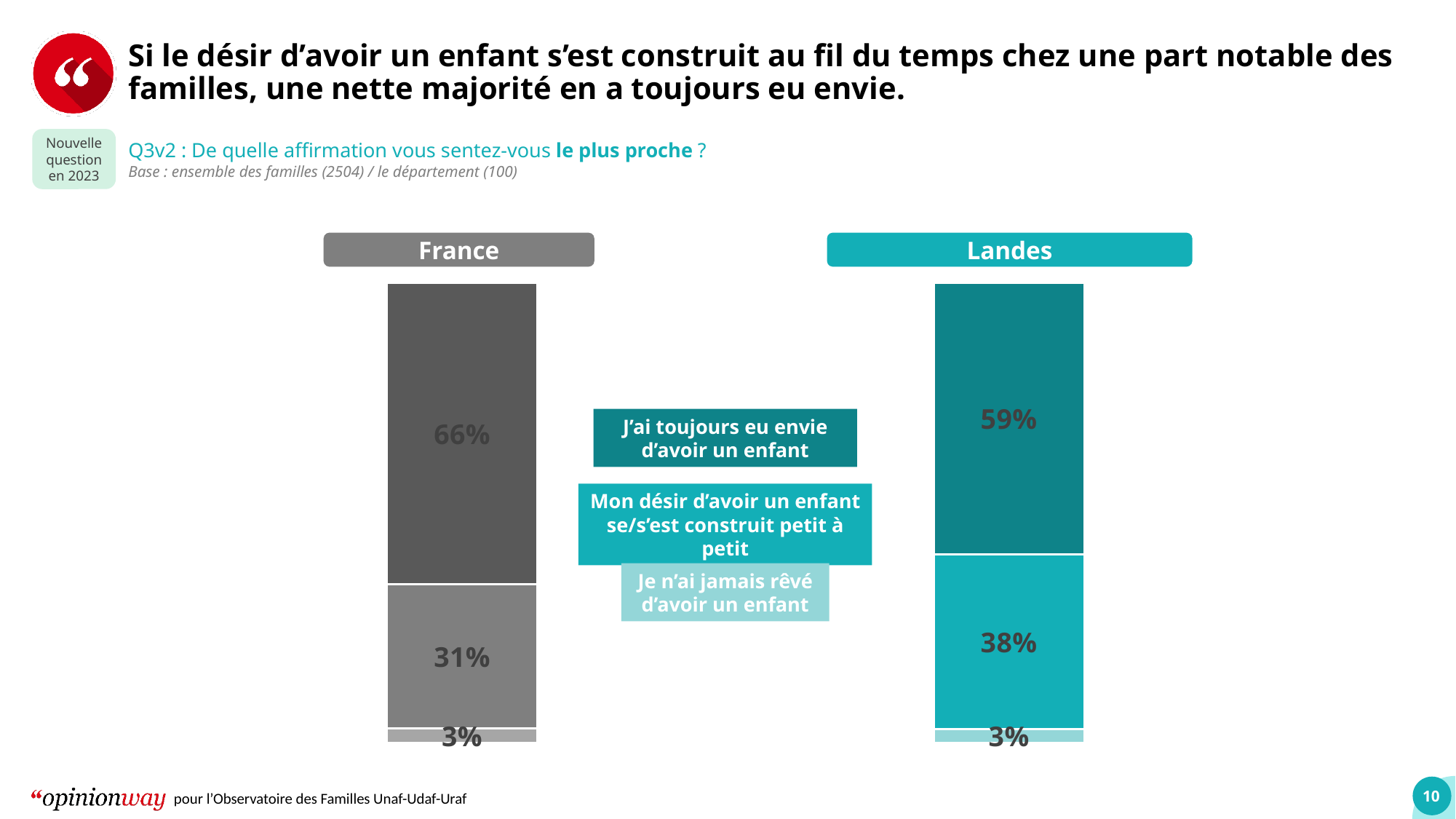
In the Landes chart, what percentage of families say "Je n'ai jamais rêvé d'avoir un enfant"? 3% In the Landes chart, what percentage of families say "Mon désir d'avoir un enfant se/s'est construit petit à petit"? 38% In the Landes chart, which response has the lowest share? Je n'ai jamais rêvé d'avoir un enfant In the Landes chart, what percentage of families say "J'ai toujours eu envie d'avoir un enfant"? 59% Which is larger: the share for "Mon désir d'avoir un enfant se/s'est construit petit à petit" in France or in Landes? Landes What is the difference between the France and Landes shares for "J'ai toujours eu envie d'avoir un enfant"? 7 percentage points In the France chart, what percentage of families say "J'ai toujours eu envie d'avoir un enfant"? 66% What type of chart is used on this slide? Stacked bar chart In the France chart, which response has the highest share? J'ai toujours eu envie d'avoir un enfant What is the total of the three segments in the France bar? 100% How many response categories are shown in each stacked bar? 3 In the France chart, what percentage of families say "Mon désir d'avoir un enfant se/s'est construit petit à petit"? 31%